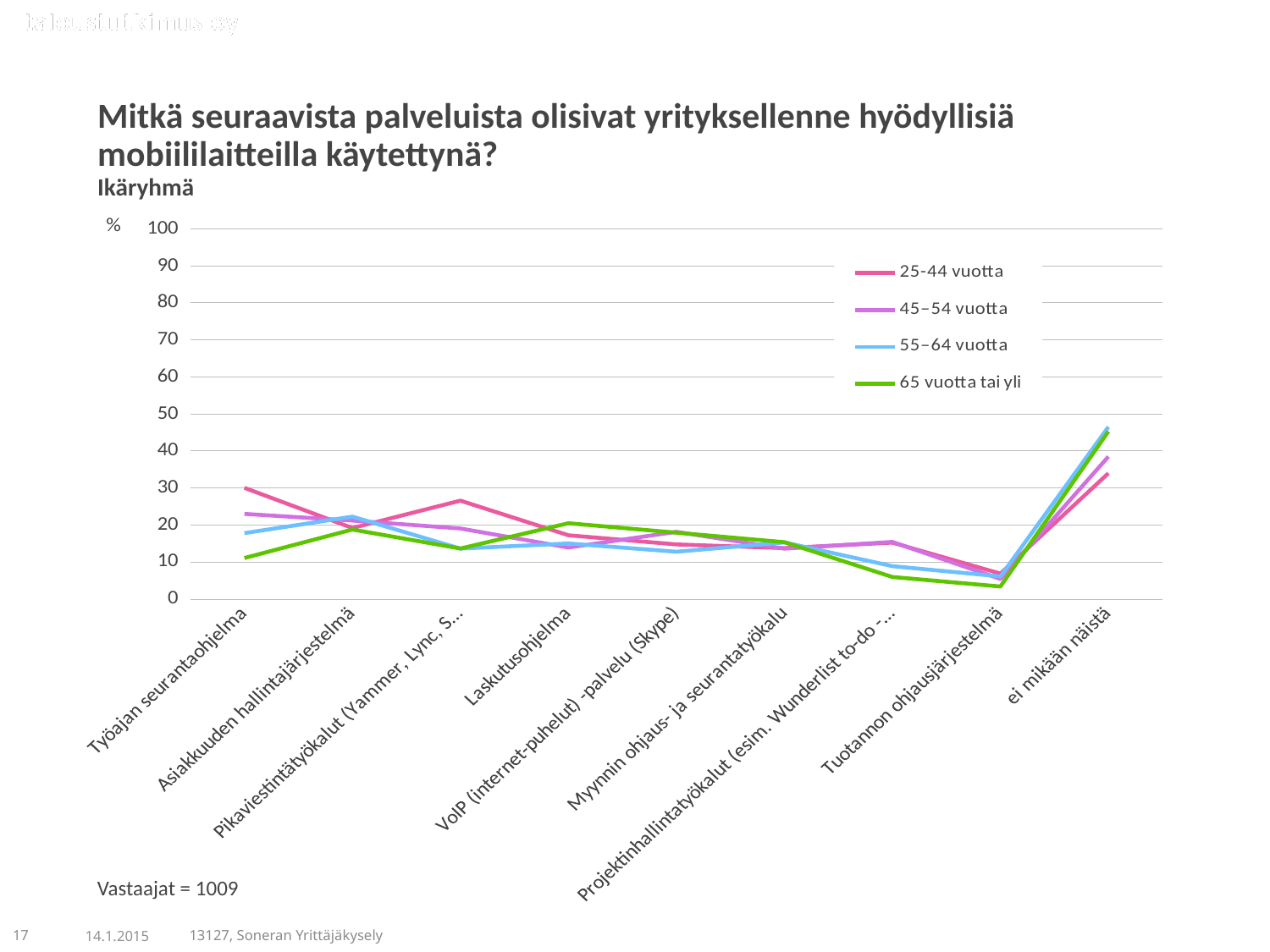
Is the value for 65 vuotta tai yli at 'Työajan seurantaohjelma' greater or less than 20? less How many categories are plotted along the x axis? 9 For the 55–64 vuotta series, which category has the highest value? ei mikään näistä Is the value for 25-44 vuotta at 'ei mikään näistä' greater or less than 40? less What kind of chart is shown on the slide? line chart Is the value for 55–64 vuotta at 'ei mikään näistä' greater or less than 40? greater For the 25-44 vuotta series, which category has the lowest value? Tuotannon ohjausjärjestelmä Do the values for all series rise or fall from 'Tuotannon ohjausjärjestelmä' to 'ei mikään näistä'? rise At 'Laskutusohjelma', which series has the larger value: 65 vuotta tai yli or 45–54 vuotta? 65 vuotta tai yli What is the number of respondents (Vastaajat) stated below the chart? 1009 How many series does the legend list? 4 At 'Työajan seurantaohjelma', which series has the larger value: 25-44 vuotta or 65 vuotta tai yli? 25-44 vuotta